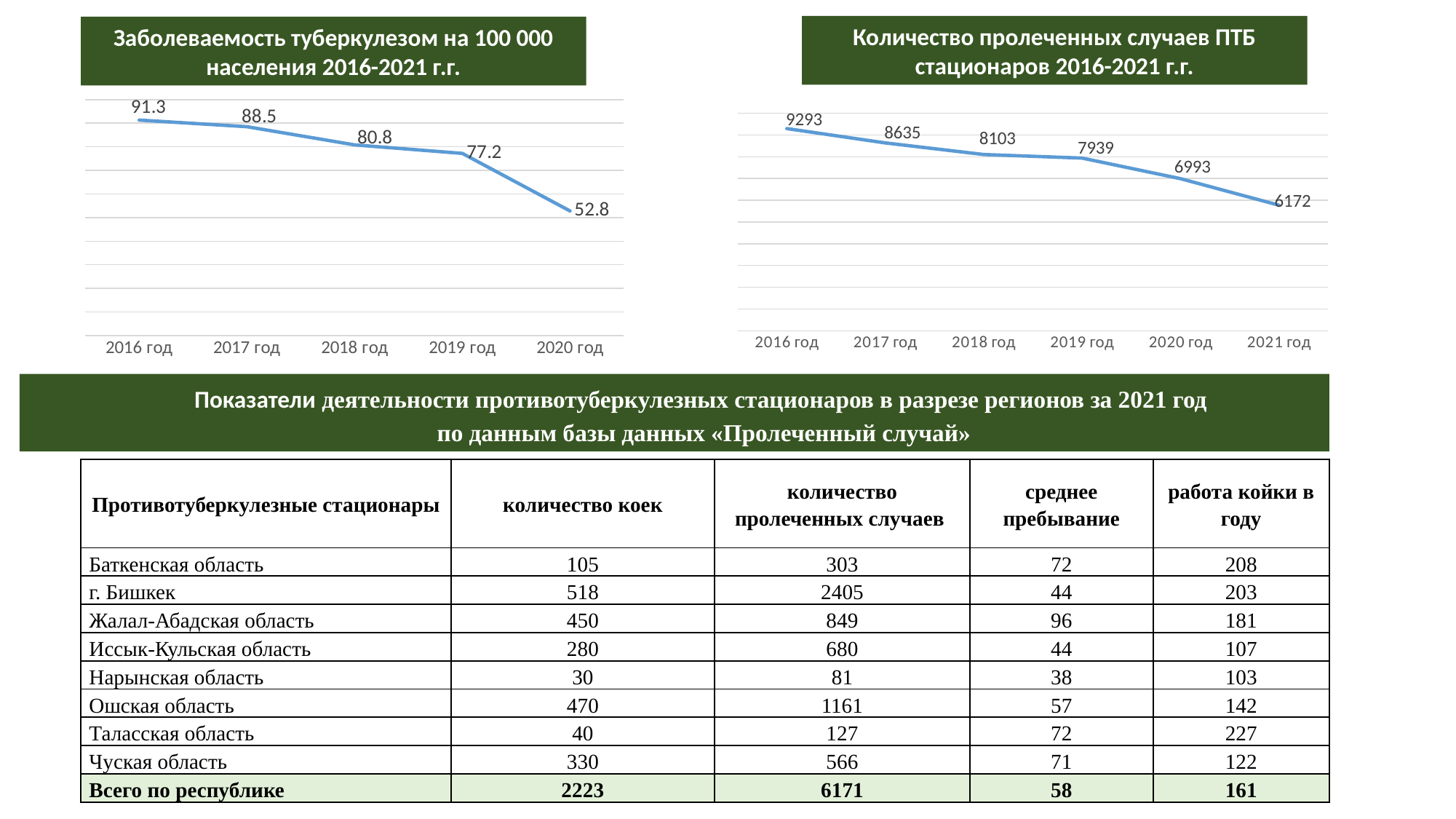
What type of chart is the right chart (Количество пролеченных случаев ПТБ стационаров)? line chart In the right chart (Количество пролеченных случаев ПТБ стационаров), which is larger, the value for 2018 год or 2020 год? 2018 год In the left chart (Заболеваемость туберкулезом на 100 000 населения), which year has the lowest value? 2020 год In the left chart (Заболеваемость туберкулезом на 100 000 населения), what is the value for 2020 год? 52.8 In the right chart (Количество пролеченных случаев ПТБ стационаров), what is the value for 2021 год? 6172 In the right chart (Количество пролеченных случаев ПТБ стационаров), what is the value for 2016 год? 9293 In the left chart (Заболеваемость туберкулезом на 100 000 населения), what is the value for 2016 год? 91.3 In the left chart (Заболеваемость туберкулезом на 100 000 населения), do the values rise or fall from 2016 год to 2020 год? fall In the left chart (Заболеваемость туберкулезом на 100 000 населения), what is the difference between the 2019 год and 2020 год values? 24.4 In the right chart (Количество пролеченных случаев ПТБ стационаров), what is the difference between the 2016 год and 2021 год values? 3121 In the left chart (Заболеваемость туберкулезом на 100 000 населения), how many years are plotted? 5 In the right chart (Количество пролеченных случаев ПТБ стационаров), which year has the highest value? 2016 год